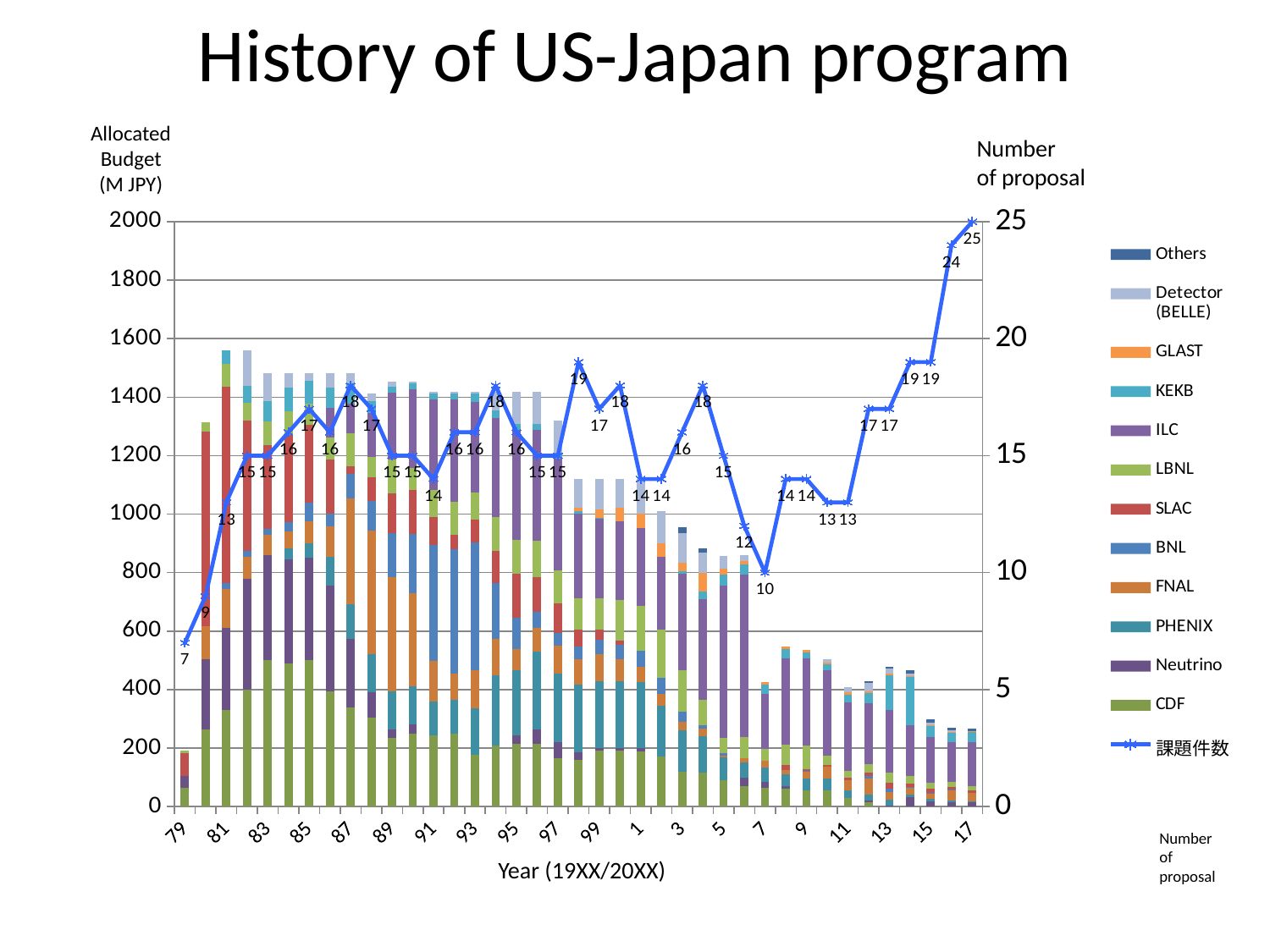
In which year does the number of proposals line reach its highest value? 17 What kind of chart is shown on the slide? Combination of a stacked bar chart and a line chart What is the number of proposals (課題件数) shown for year 7? 10 Which year has more proposals, 98 or 99? 98 What is the difference between the number of proposals in year 98 and in year 7? 9 What is the number of proposals (課題件数) shown for year 79? 7 What is the number of proposals (課題件数) shown for year 17? 25 In which year does the number of proposals line have its lowest value? 79 How many entries does the legend list? 13 Is the total allocated budget bar for year 7 greater or less than 600? less Is the total allocated budget bar for year 81 greater or less than 1400? greater By how much does the number of proposals in year 17 exceed that in year 16? 1